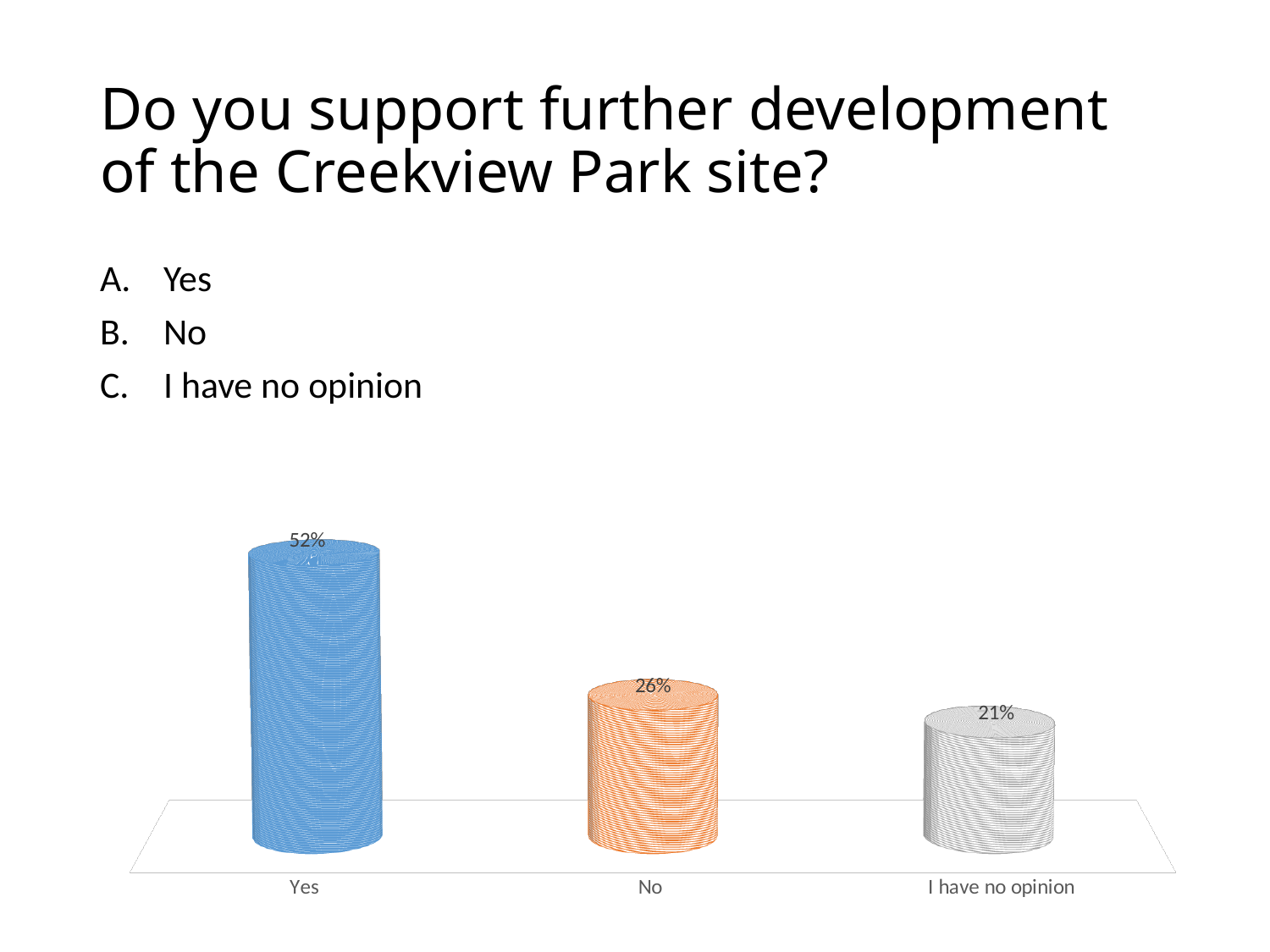
How many response categories are shown in the chart? 3 What is the difference in percentage points between "No" and "I have no opinion"? 5 Which response received the lowest percentage? I have no opinion What is the difference in percentage points between "Yes" and "No"? 26 Which response received the highest percentage? Yes What percentage of respondents answered "Yes"? 52% What kind of chart is shown on the slide? Bar chart What colour is the bar for "Yes"? Blue What percentage of respondents answered "I have no opinion"? 21% Which is larger, the percentage for "No" or for "I have no opinion"? No Do the values rise or fall from left to right across the categories? Fall What percentage of respondents answered "No"? 26%